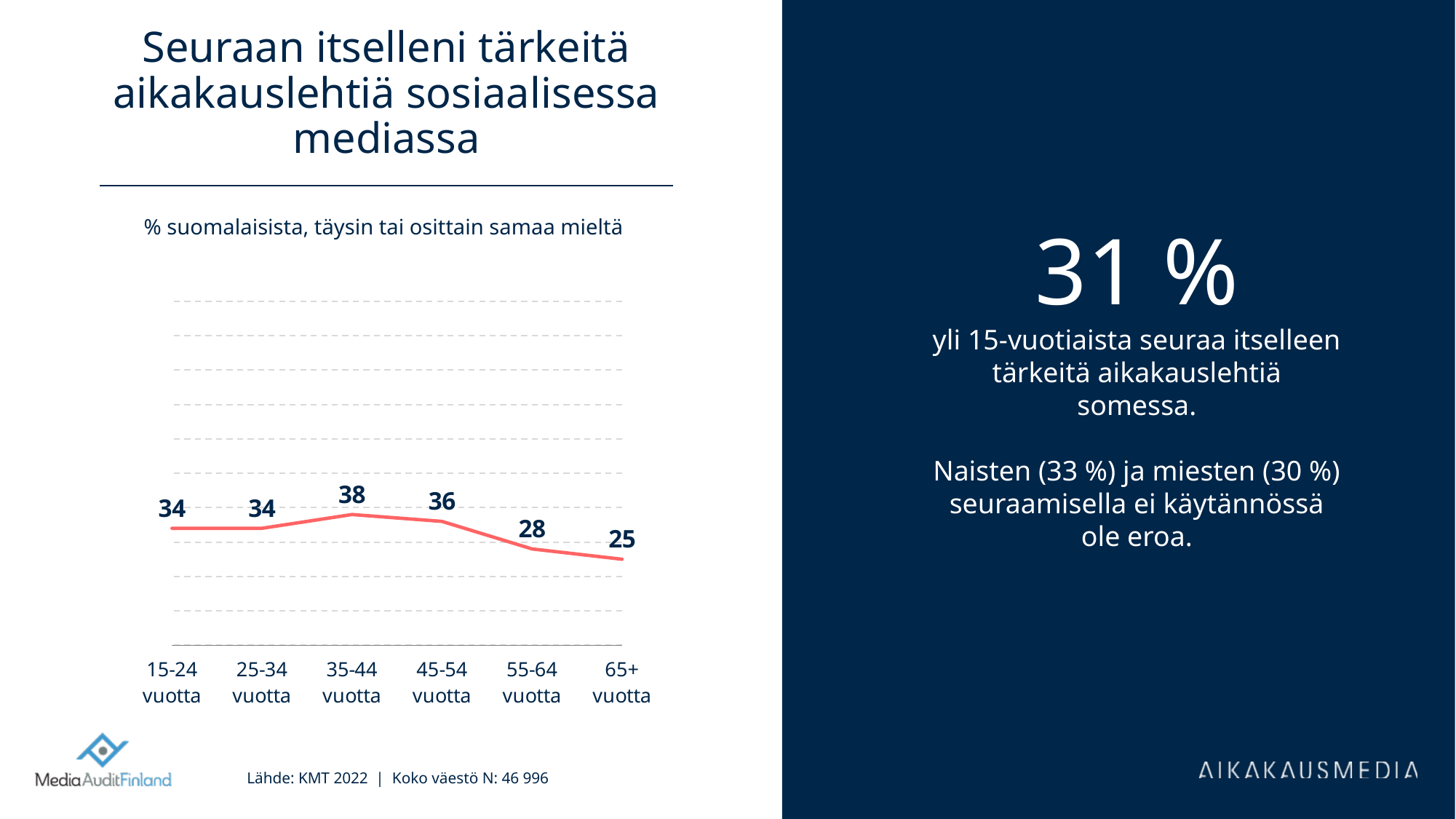
What is the value for the 55-64 vuotta age group? 28 What is the difference between the values for 35-44 vuotta and 65+ vuotta? 13 Do the values rise or fall from the 35-44 vuotta group to the 65+ vuotta group? Fall What is the value for the 65+ vuotta age group? 25 Which is larger, the value for 45-54 vuotta or the value for 55-64 vuotta? 45-54 vuotta What is the difference between the values for 45-54 vuotta and 55-64 vuotta? 8 What is the value for the 35-44 vuotta age group? 38 Which age group has the lowest value? 65+ vuotta What kind of chart is shown on the slide? Line chart How many age groups are shown on the x axis? 6 Which age group has the highest value? 35-44 vuotta What is the title of the chart? Seuraan itselleni tärkeitä aikakauslehtiä sosiaalisessa mediassa